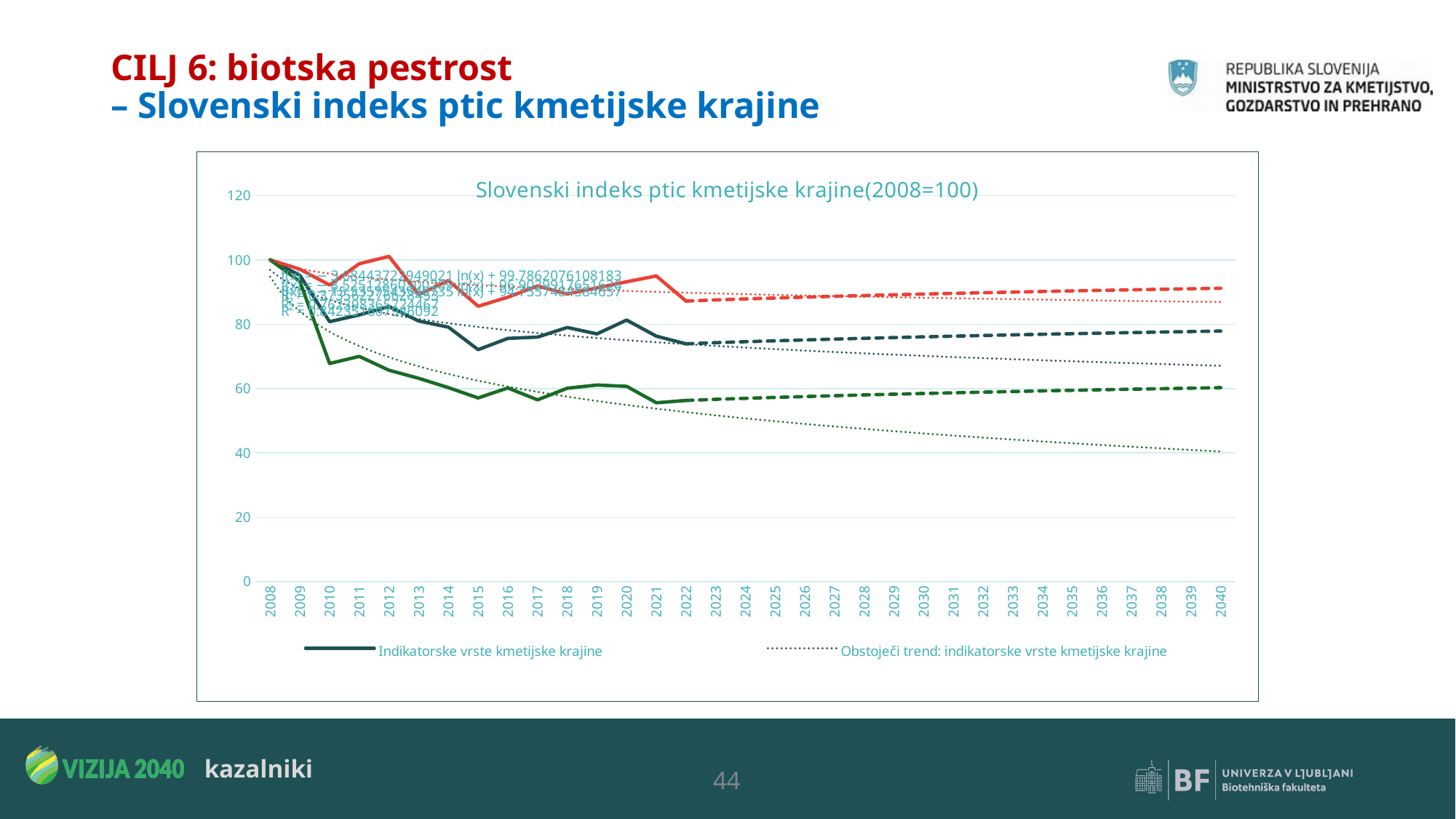
Is the value of the dark teal solid line in 2015 greater or less than 80? less Is the value of the green dotted trend line in 2030 greater or less than 60? less What is the first year shown on the x axis? 2008 What kind of chart is shown on the slide? line chart Is the value of the red solid line in 2022 greater or less than 80? greater How many series does the chart legend list? 2 Do the solid index lines generally rise or fall from 2008 to 2022? fall What is the title of the chart? Slovenski indeks ptic kmetijske krajine(2008=100) What is the index value of the lines in 2008, the base year? 100 In 2020, which is higher: the red solid line or the green solid line? the red solid line How many years are labelled on the x axis of the chart? 33